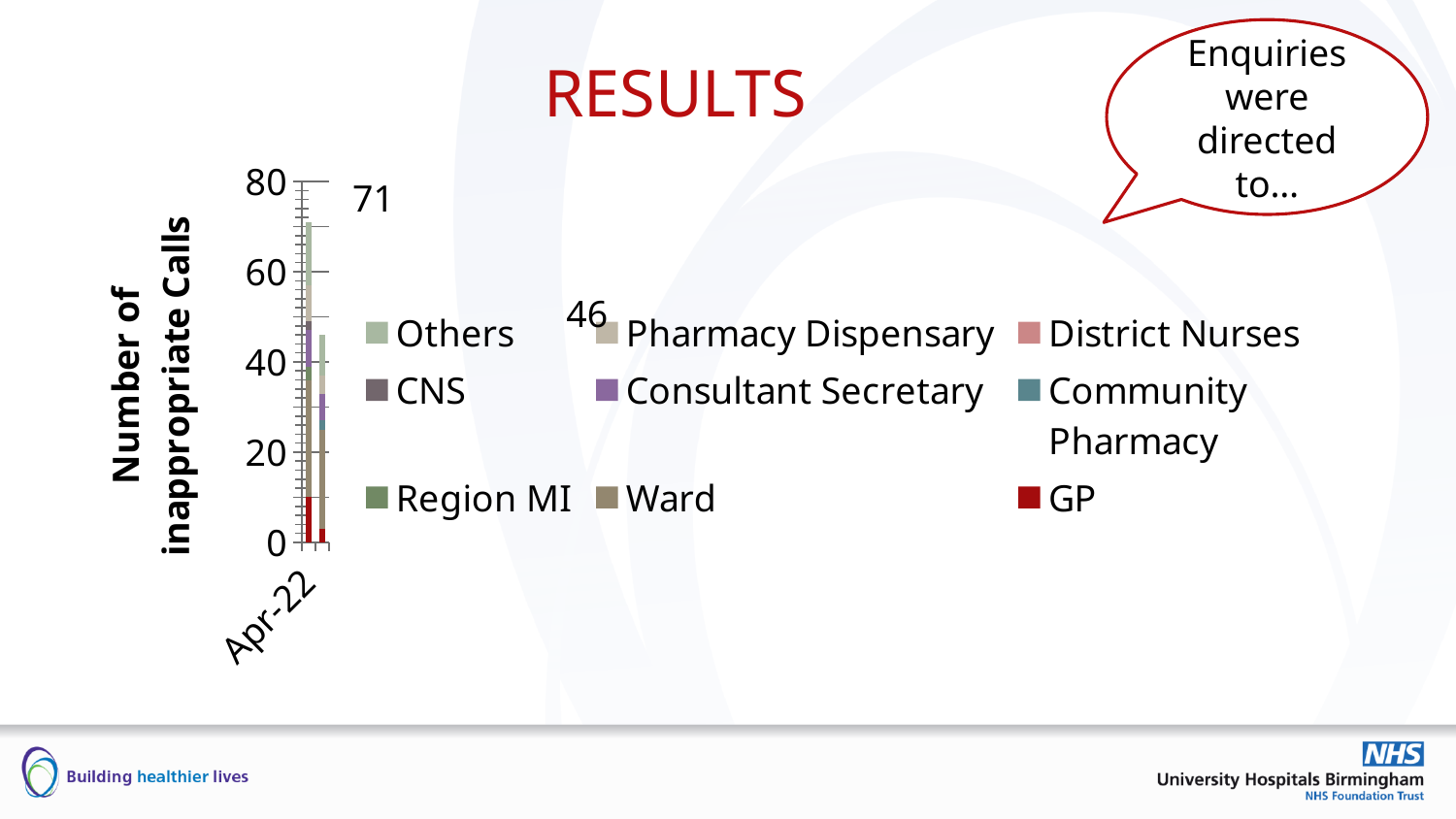
What is the lowest bar total printed as a data label on the chart? 46 What kind of chart is shown on the slide? Stacked bar chart What is the highest bar total printed as a data label on the chart? 71 Is the bar total of 71 greater or less than 80 on the vertical axis? less What is the label on the chart's vertical axis? Number of inappropriate Calls How many series does the chart's legend list? 9 How many bars are plotted on the chart? 2 What is the difference between the two bar totals printed on the chart, 71 and 46? 25 Is the bar total of 46 greater or less than 40 on the vertical axis? greater Which legend entry is shown in red? GP Which of the two printed bar totals is larger, 71 or 46? 71 What is the highest value shown on the chart's vertical axis? 80